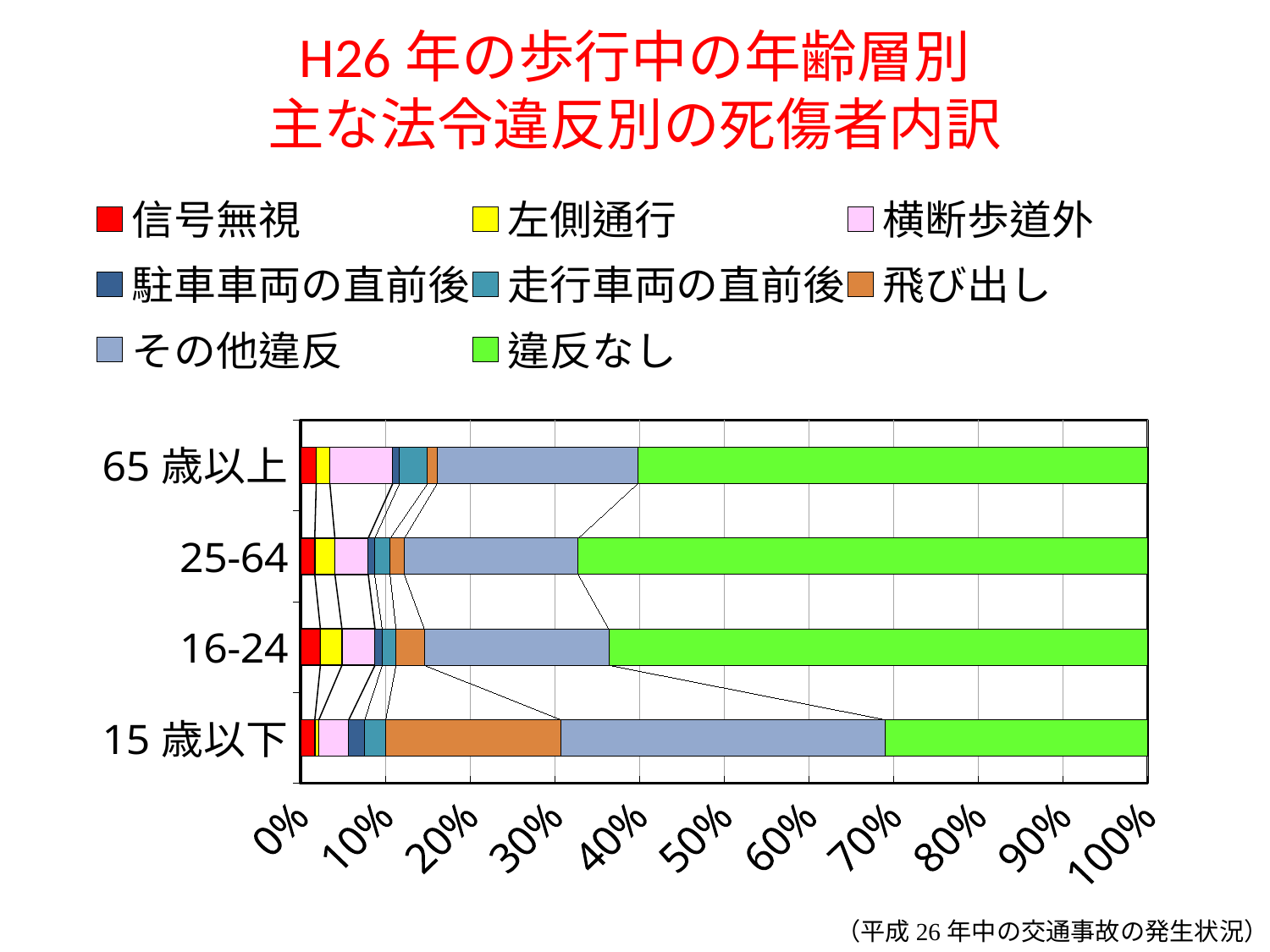
Which age group has the smallest share of 違反なし? 15歳以下 Is the share of その他違反 for 15歳以下 greater or less than 30%? greater What kind of chart is shown on the slide? stacked bar chart Is the share of 違反なし for 65歳以上 greater or less than 50%? greater Is the share of 違反なし for 15歳以下 greater or less than 40%? less How many age groups are shown on the chart? 4 How many series does the legend list? 8 Which has a larger share of 違反なし, 65歳以上 or 15歳以下? 65歳以上 What is the source noted below the chart? 平成26年中の交通事故の発生状況 Which colour represents 違反なし in the legend? green Which age group has the largest share of 飛び出し? 15歳以下